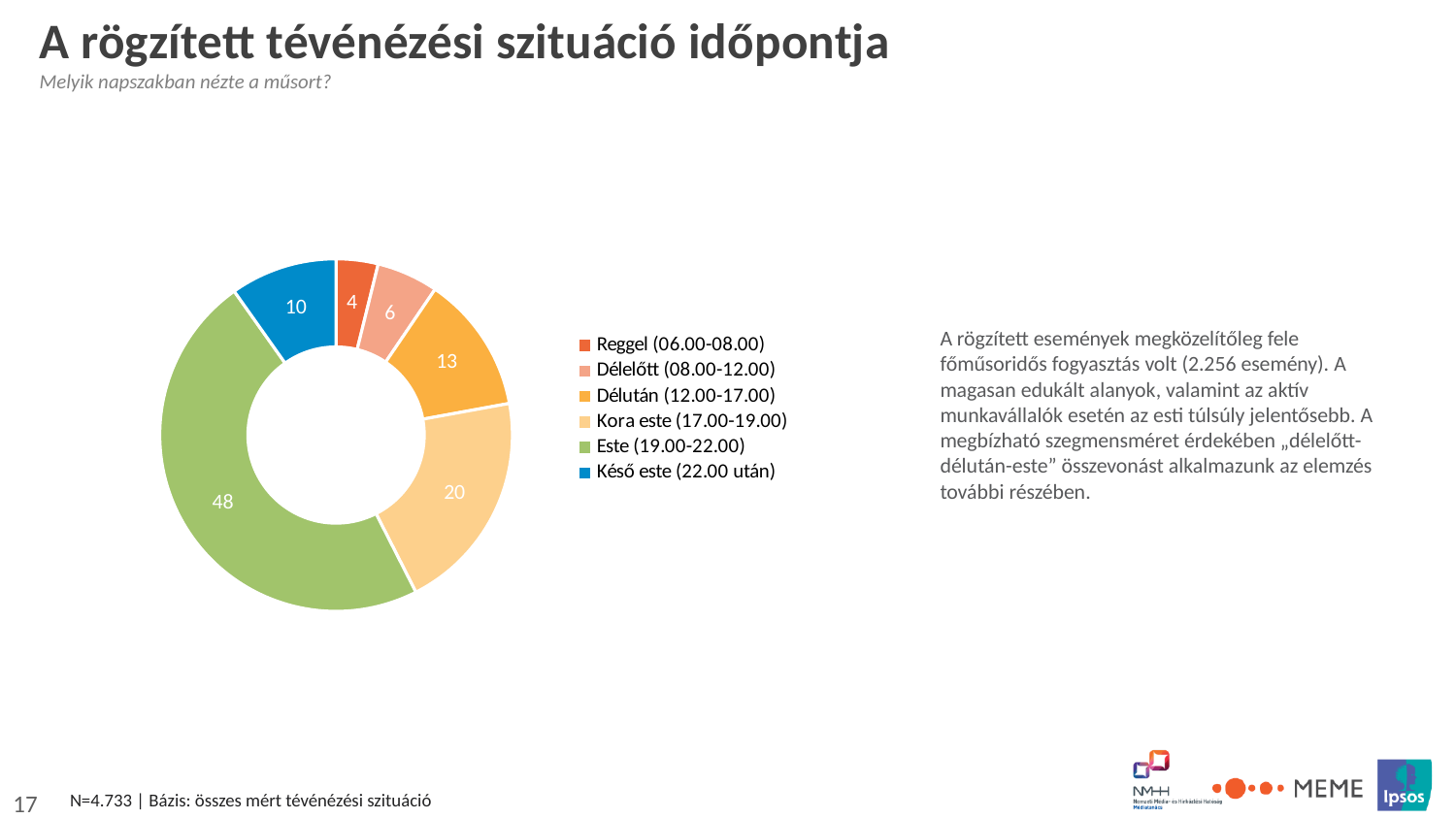
Which is larger, the value for Délelőtt (08.00-12.00) or the value for Késő este (22.00 után)? Késő este (22.00 után) What value is shown for Kora este (17.00-19.00)? 20 What value is shown for Reggel (06.00-08.00)? 4 What colour is the slice for Este (19.00-22.00)? green What value is shown for Késő este (22.00 után)? 10 What kind of chart is shown on the slide? doughnut chart How many categories does the chart show? 6 Which time slot has the largest slice? Este (19.00-22.00) What is the difference between the values for Este (19.00-22.00) and Kora este (17.00-19.00)? 28 What value is shown for Délután (12.00-17.00)? 13 Which time slot has the smallest slice? Reggel (06.00-08.00) What value is shown for Este (19.00-22.00)? 48